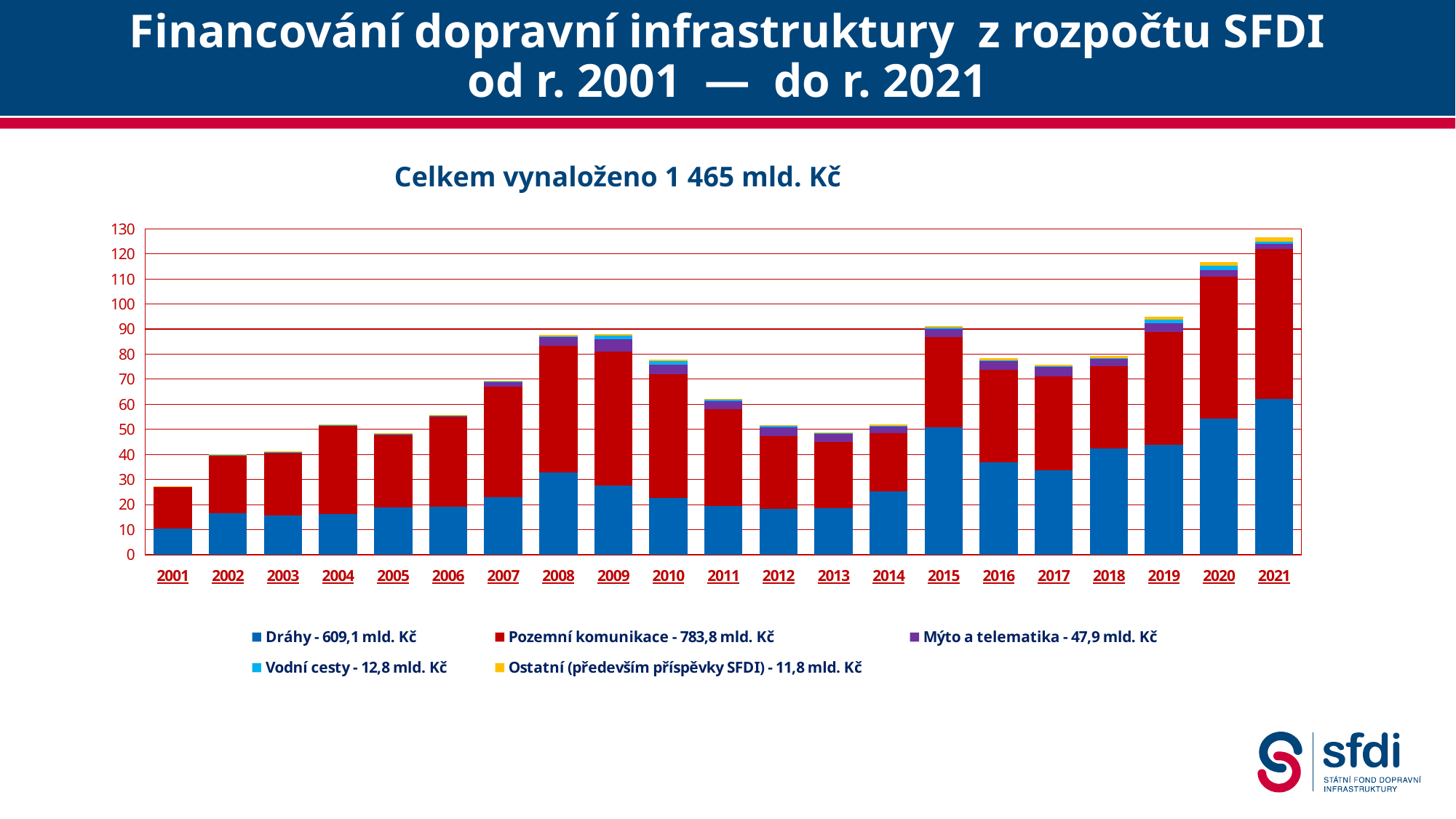
Is the total value for 2020 greater or less than 110? greater According to the legend, what is the total for Pozemní komunikace? 783,8 mld. Kč Which year has the highest total bar? 2021 Is the total value for 2001 greater or less than 30? less What total amount is stated in the chart title above the chart? 1 465 mld. Kč Which year has the lowest total bar? 2001 What kind of chart is shown on the slide? stacked bar chart How many series does the chart legend list? 5 Which year has the larger total bar, 2019 or 2020? 2020 How many years are shown on the x axis of the chart? 21 Is the total value for 2021 greater or less than 120? greater